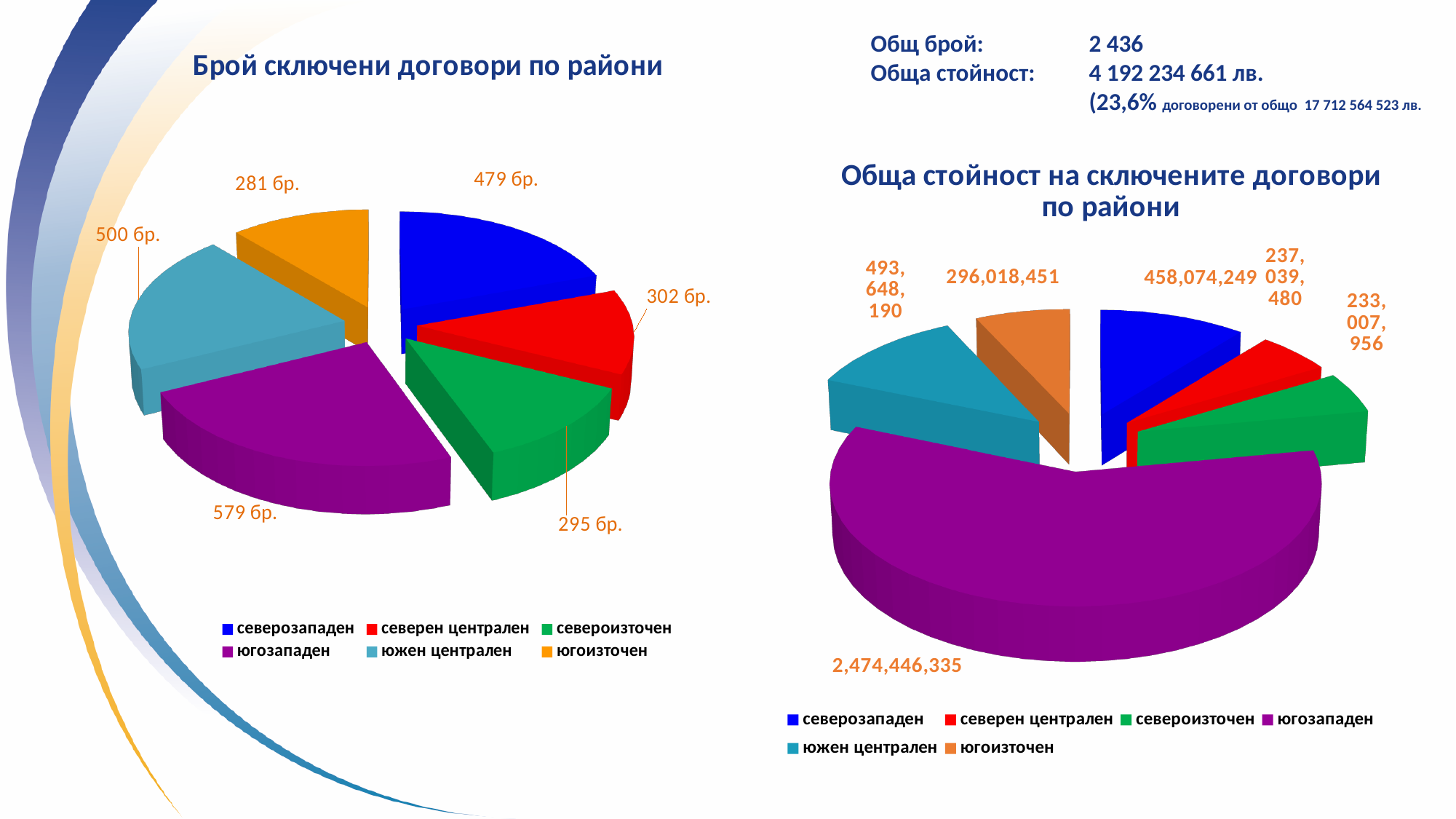
How many regions are shown in the chart 'Брой сключени договори по райони'? 6 In the chart 'Обща стойност на сключените договори по райони', what is the value for югозападен? 2,474,446,335 In the chart 'Брой сключени договори по райони', which is larger: северен централен or североизточен? северен централен In the chart 'Обща стойност на сключените договори по райони', what is the value for северозападен? 458,074,249 In the chart 'Обща стойност на сключените договори по райони', which region has the lowest value? североизточен In the chart 'Брой сключени договори по райони', which region has the lowest number of contracts? югоизточен In the chart 'Брой сключени договори по райони', what is the value for южен централен? 500 бр. In the chart 'Брой сключени договори по райони', which region has the highest number of contracts? югозападен In the chart 'Брой сключени договори по райони', what is the difference between the values for югозападен and югоизточен? 298 In the chart 'Брой сключени договори по райони', what is the value for югозападен? 579 бр. What type of chart is 'Обща стойност на сключените договори по райони'? Pie chart In the chart 'Обща стойност на сключените договори по райони', what is the difference between the values for южен централен and северозападен? 35,573,941